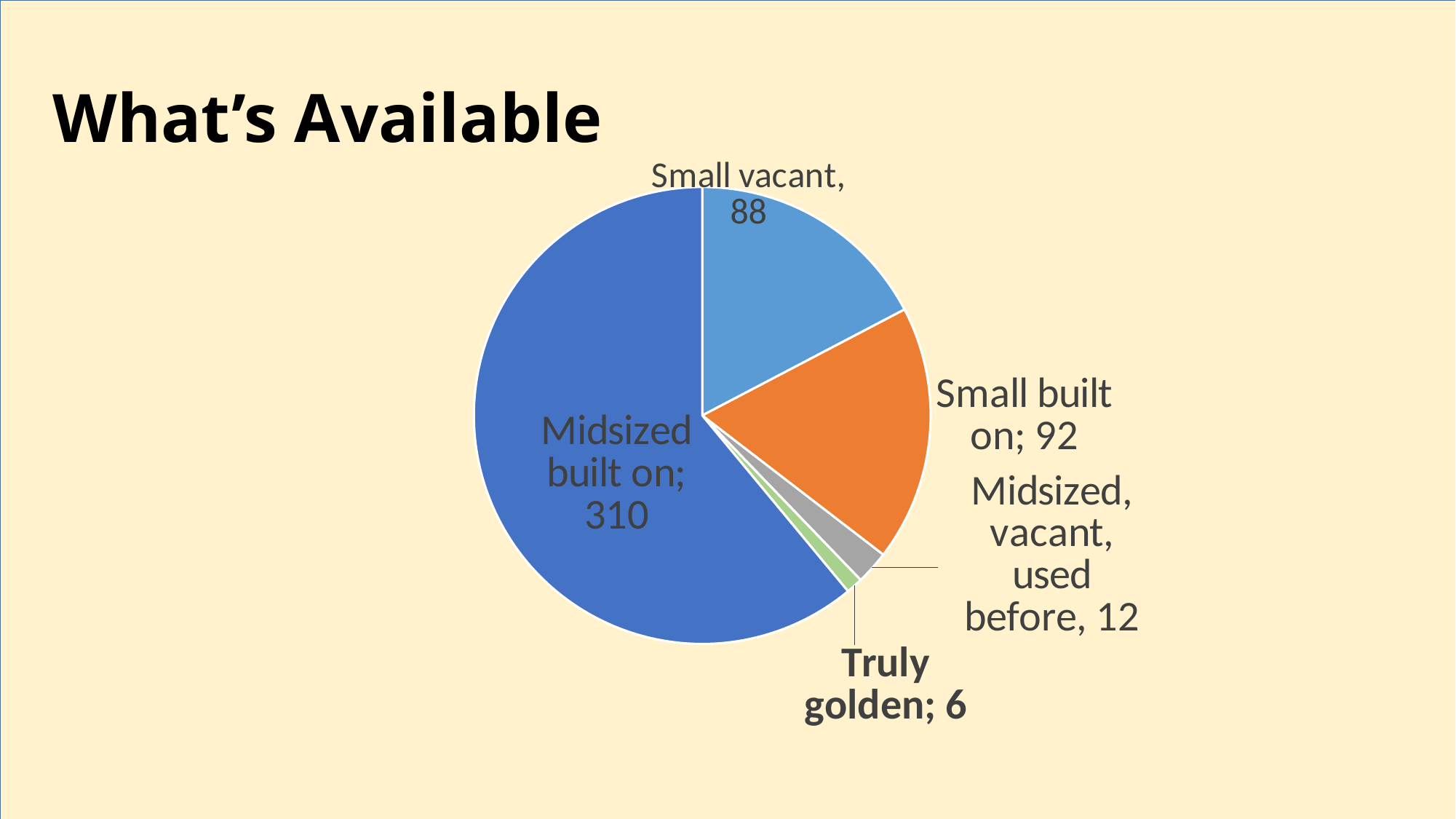
What is the title of the slide? What's Available What is the value for Small vacant? 88 Which is larger, Midsized, vacant, used before or Truly golden? Midsized, vacant, used before What is the difference between Small built on and Small vacant? 4 Which category has the smallest slice? Truly golden How many slices does the pie chart have? 5 What is the total of all slices in the pie chart? 508 What is the value for Truly golden? 6 Which category has the largest slice? Midsized built on What kind of chart is shown on the slide? Pie chart What is the value for Midsized built on? 310 What is the value for Midsized, vacant, used before? 12